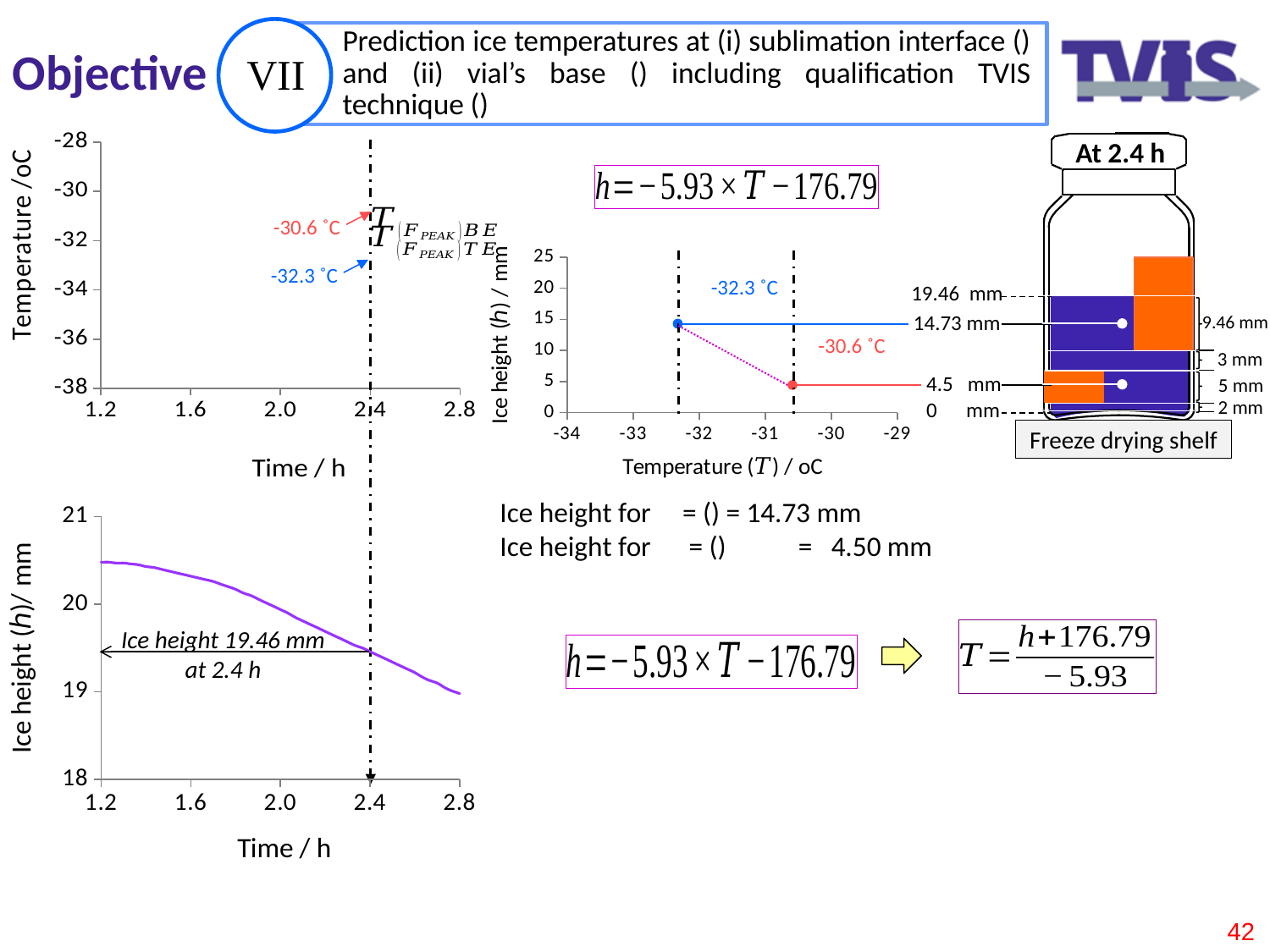
In the middle chart of ice height against temperature, how many data points are plotted? 2 What kind of chart is the bottom-left chart of ice height against time? line chart In the middle chart of ice height against temperature, what is the ice height at -32.3 °C? 14.73 mm In the bottom-left chart of ice height against time, is the ice height at 1.2 h greater or less than 20 mm? greater In the middle chart of ice height against temperature, what is the difference between the ice heights at -32.3 °C and -30.6 °C? 10.23 mm What is the x-axis label of the middle chart of ice height against temperature? Temperature (T) / oC In the middle chart of ice height against temperature, which temperature has the larger ice height, -32.3 °C or -30.6 °C? -32.3 °C In the middle chart of ice height against temperature, what is the ice height at -30.6 °C? 4.5 mm In the top-left chart of temperature against time, what are the two temperatures annotated at 2.4 h? -30.6 °C and -32.3 °C In the bottom-left chart of ice height against time, is the ice height at 2.8 h greater or less than 19.5 mm? less In the bottom-left chart of ice height against time, does the ice height rise or fall as time increases from 1.2 h to 2.8 h? fall In the bottom-left chart of ice height against time, what is the ice height at 2.4 h according to the annotation? 19.46 mm